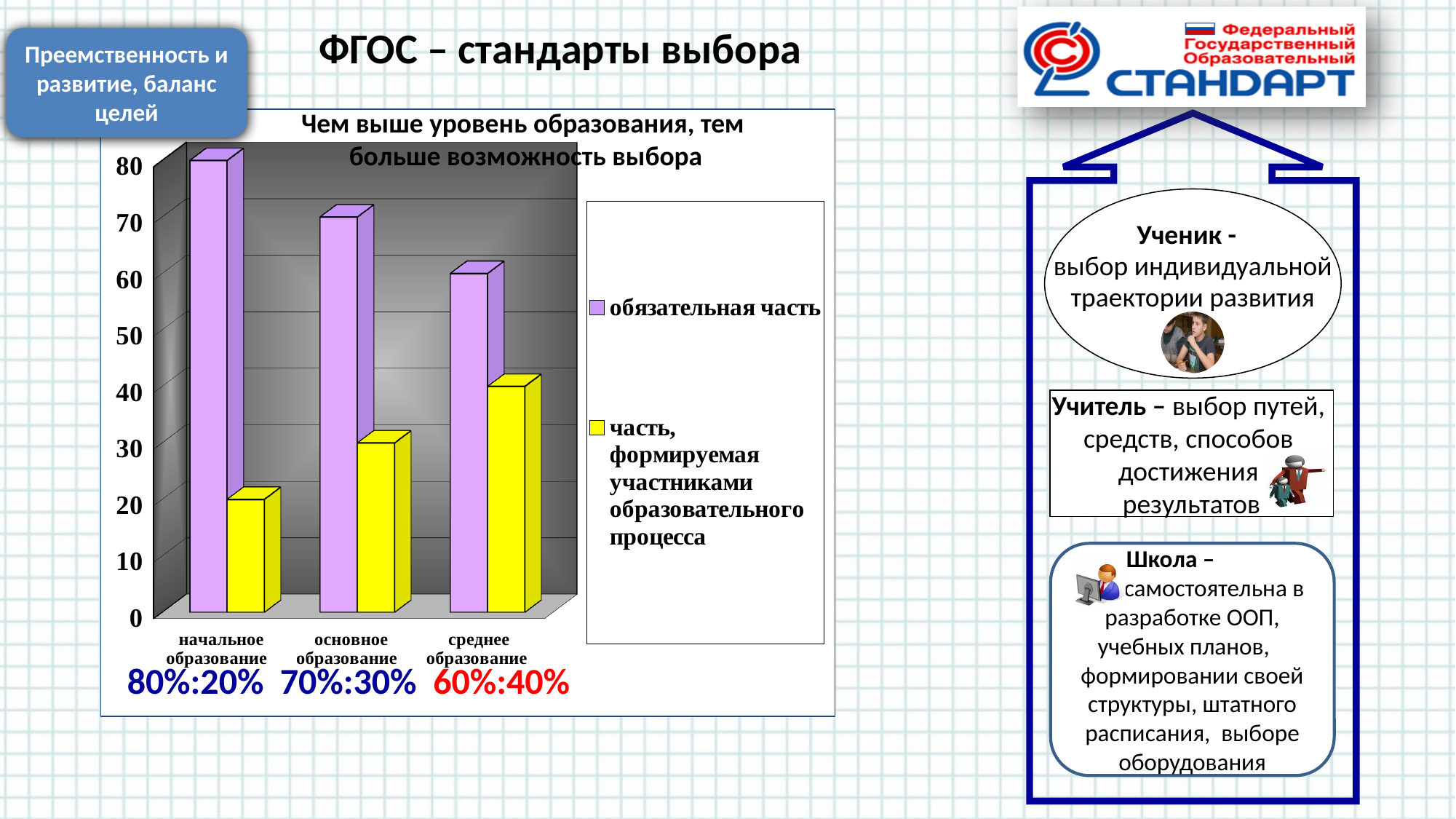
Which category has the lowest value for 'часть, формируемая участниками образовательного процесса'? начальное образование How many categories are shown on the x axis of the chart? 3 What kind of chart is shown on the slide? bar chart What is the value of 'обязательная часть' for 'начальное образование'? 80 How many series does the chart legend list? 2 What ratio label is printed under 'среднее образование' on the chart? 60%:40% What is the value of 'обязательная часть' for 'основное образование'? 70 What is the difference between 'обязательная часть' and 'часть, формируемая участниками образовательного процесса' for 'среднее образование'? 20 Do the values of 'обязательная часть' rise or fall from 'начальное образование' to 'среднее образование'? fall Which category has the highest value for 'обязательная часть'? начальное образование What is the value of 'часть, формируемая участниками образовательного процесса' for 'среднее образование'? 40 Which is larger for 'основное образование': 'обязательная часть' or 'часть, формируемая участниками образовательного процесса'? обязательная часть